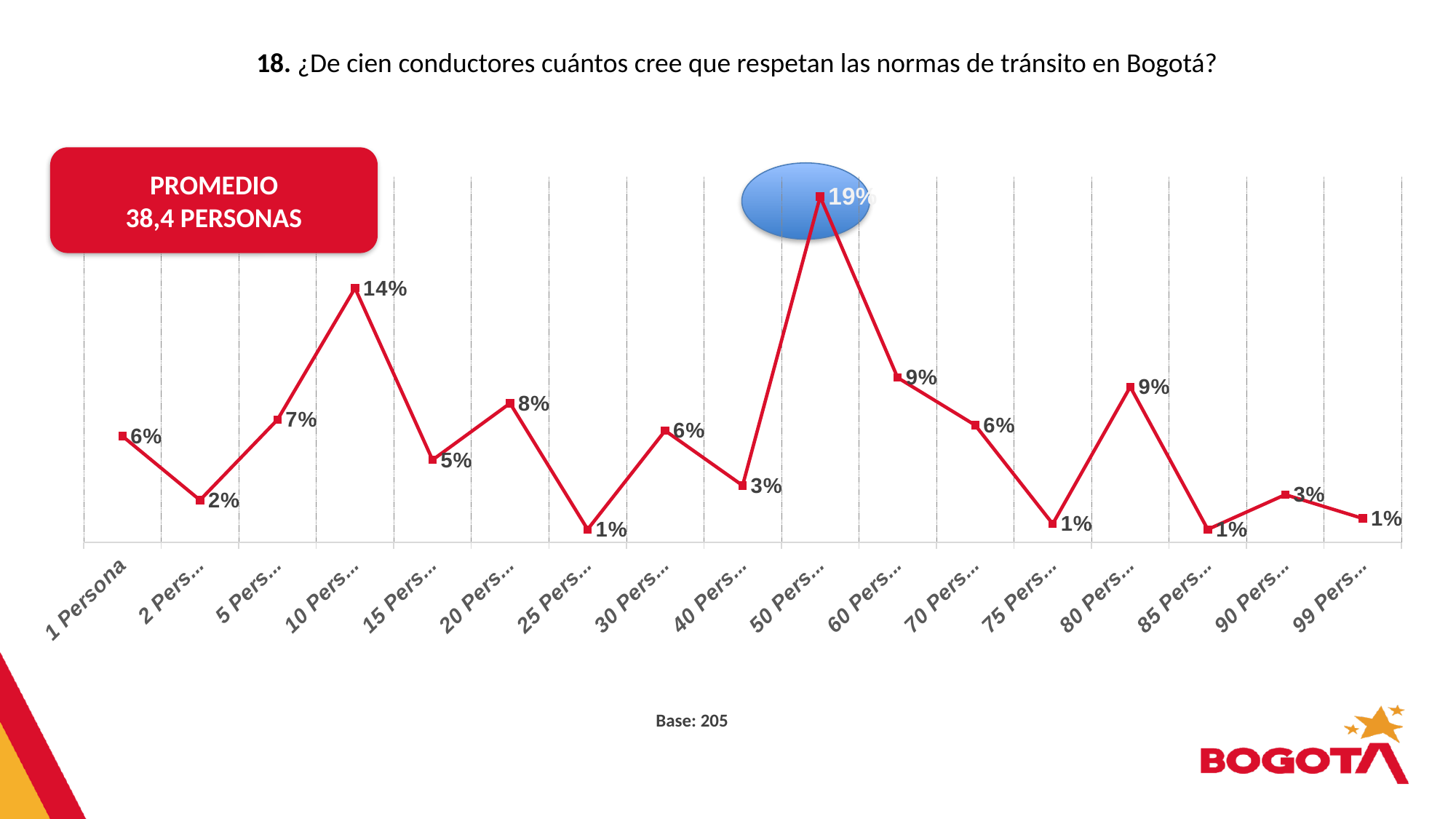
What is the value for 50 Personas? 19% What is the difference between the values for 50 Personas and 10 Personas? 5% Which is larger, the value for 20 Personas or the value for 15 Personas? 20 Personas What is the lowest value plotted on the chart? 1% What average (promedio) is shown in the red box on the slide? 38,4 personas Which category has the highest value? 50 Personas How many data points are plotted on the chart? 17 What is the value for 80 Personas? 9% What type of chart is shown on the slide? line chart What is the value for 1 Persona? 6% What is the value for 10 Personas? 14% What is the base (sample size) stated below the chart? 205